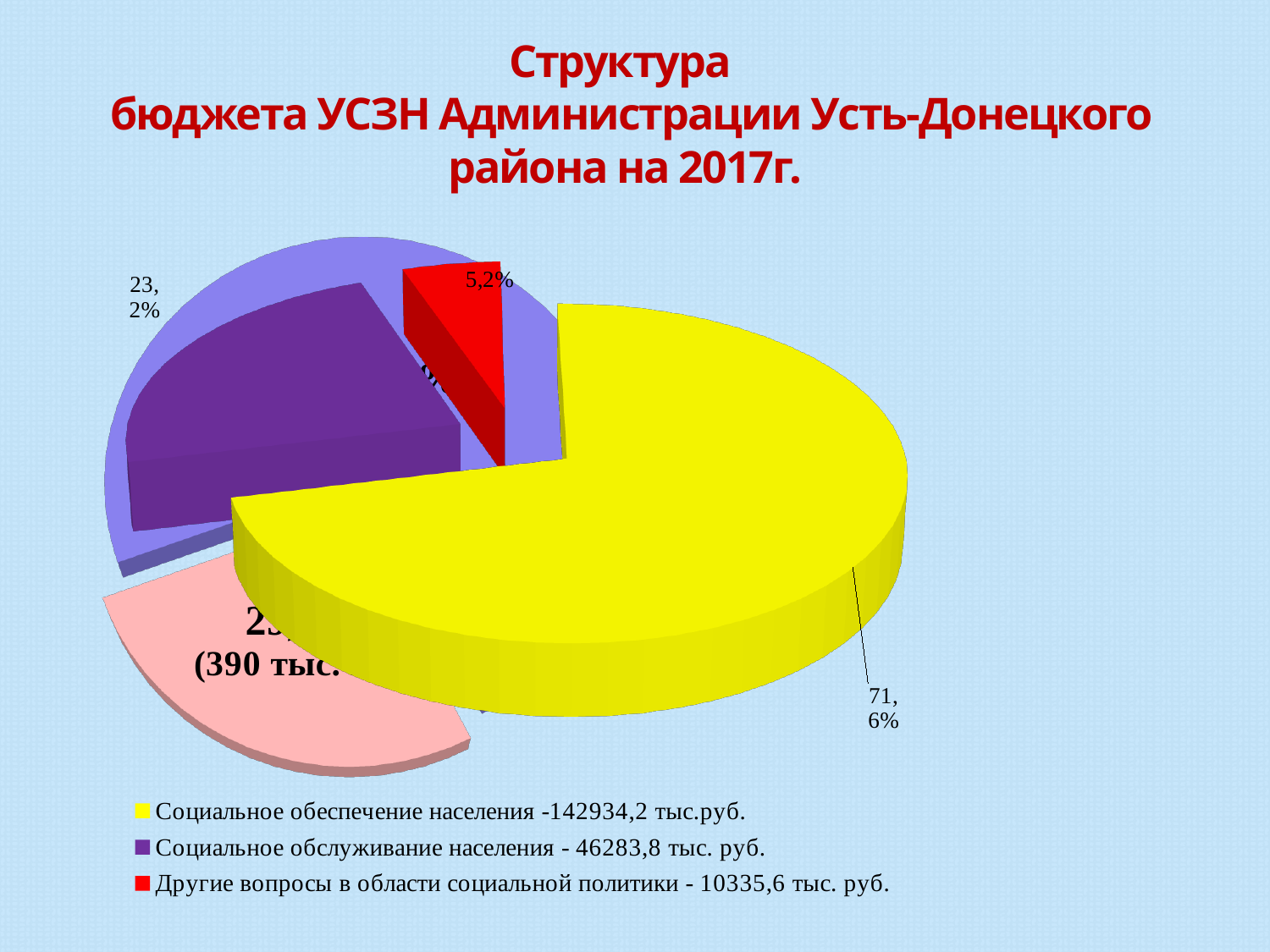
What percentage share is labelled on the slice for Другие вопросы в области социальной политики? 5,2% According to the legend, what amount is given for Социальное обслуживание населения? 46283,8 тыс. руб. What percentage share is labelled on the slice for Социальное обслуживание населения? 23,2% What colour is the slice for Социальное обеспечение населения? Yellow What is the difference in percentage points between the shares of Социальное обеспечение населения and Социальное обслуживание населения? 48,4% Which category has the smallest slice of the pie? Другие вопросы в области социальной политики How many entries does the legend list? 3 What percentage share is labelled on the slice for Социальное обеспечение населения? 71,6% Which category has the largest slice of the pie? Социальное обеспечение населения What kind of chart is shown on the slide? Pie chart Which slice is larger: Социальное обслуживание населения or Другие вопросы в области социальной политики? Социальное обслуживание населения